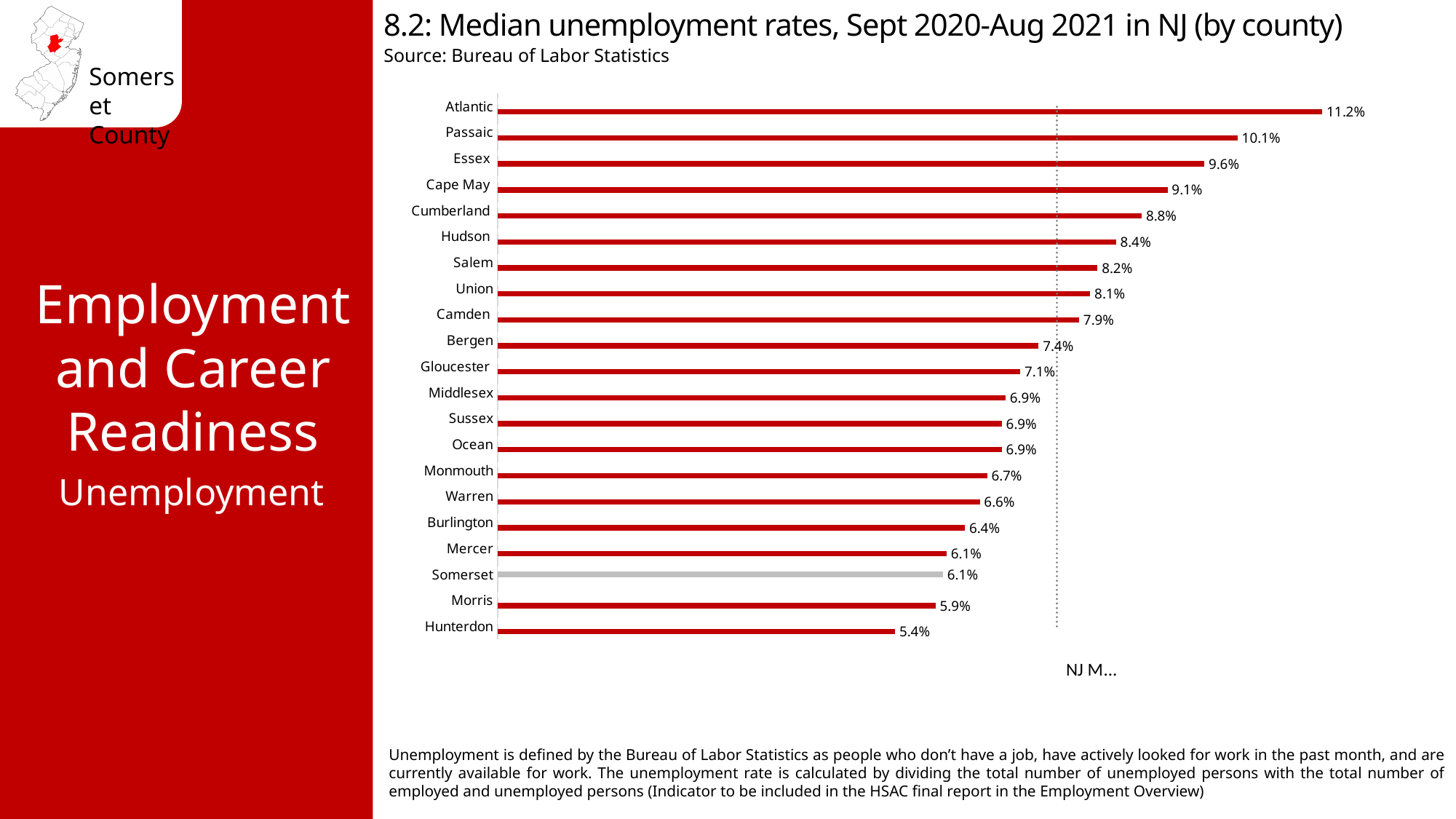
Which county has a higher median unemployment rate, Essex or Cape May? Essex What is the median unemployment rate for Somerset County? 6.1% What is the difference between the median unemployment rates of Passaic and Somerset counties? 4.0% What is the median unemployment rate for Atlantic County? 11.2% Which county has the highest median unemployment rate? Atlantic What type of chart is used to show the median unemployment rates? Bar chart What is the difference between the median unemployment rates of Atlantic and Hunterdon counties? 5.8% Which county has the lowest median unemployment rate? Hunterdon What is the median unemployment rate for Hudson County? 8.4% How many counties are shown in the chart? 21 Which county has a higher median unemployment rate, Morris or Warren? Warren Which county's bar is shown in grey rather than red? Somerset